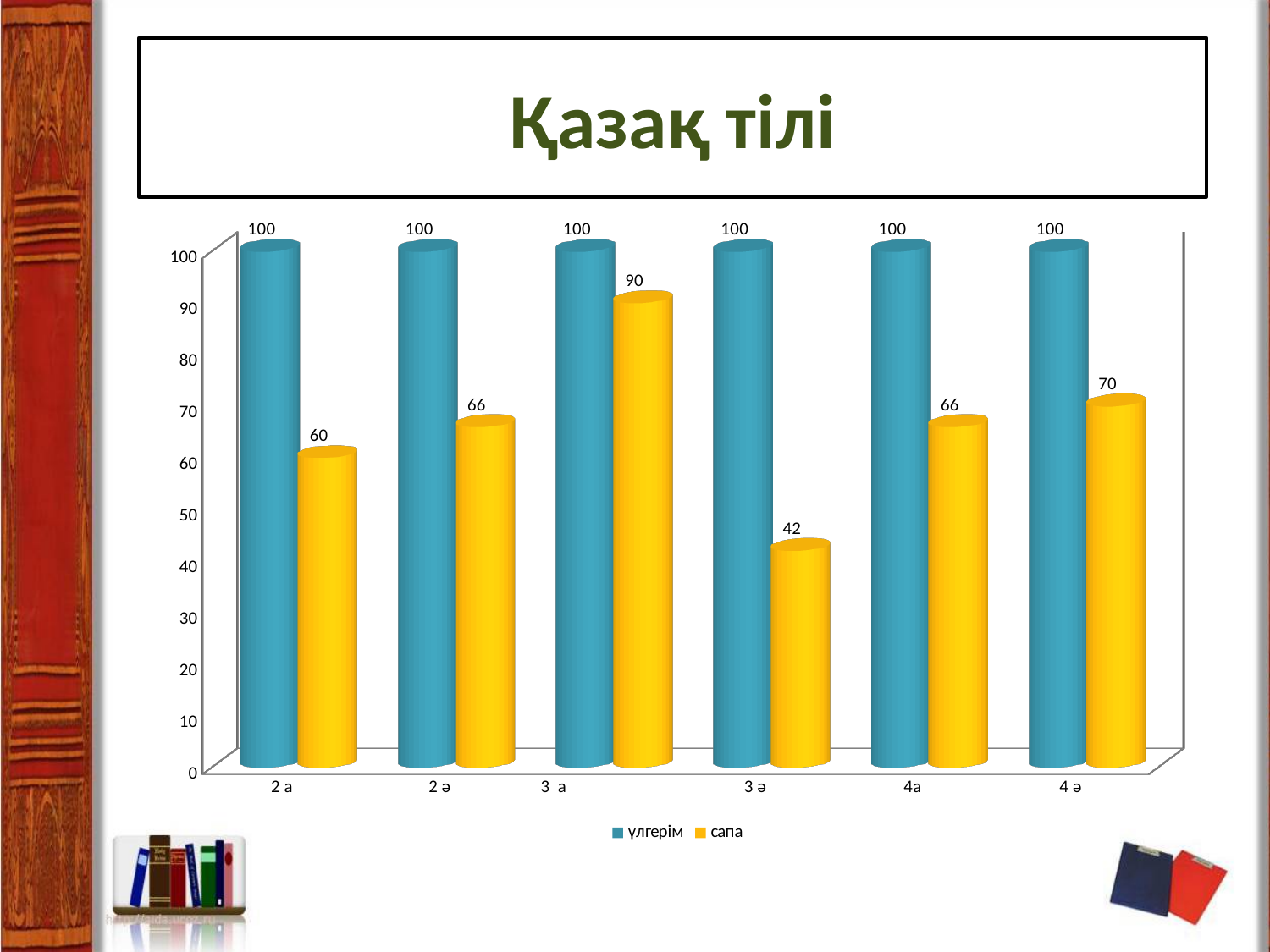
What is the title of the slide? Қазақ тілі What is the difference between the сапа values for 3 а and 3 ә? 48 Which is larger, the сапа value for 4 ә or the сапа value for 2 ә? 4 ә What kind of chart is shown on the slide? bar chart What is the сапа value for 3 ә? 42 How many categories are shown on the x axis? 6 How many series does the legend list? 2 What is the сапа value for 2 а? 60 Which category has the lowest сапа value? 3 ә What is the үлгерім value for 4а? 100 Which category has the highest сапа value? 3 а Which series is shown in yellow? сапа